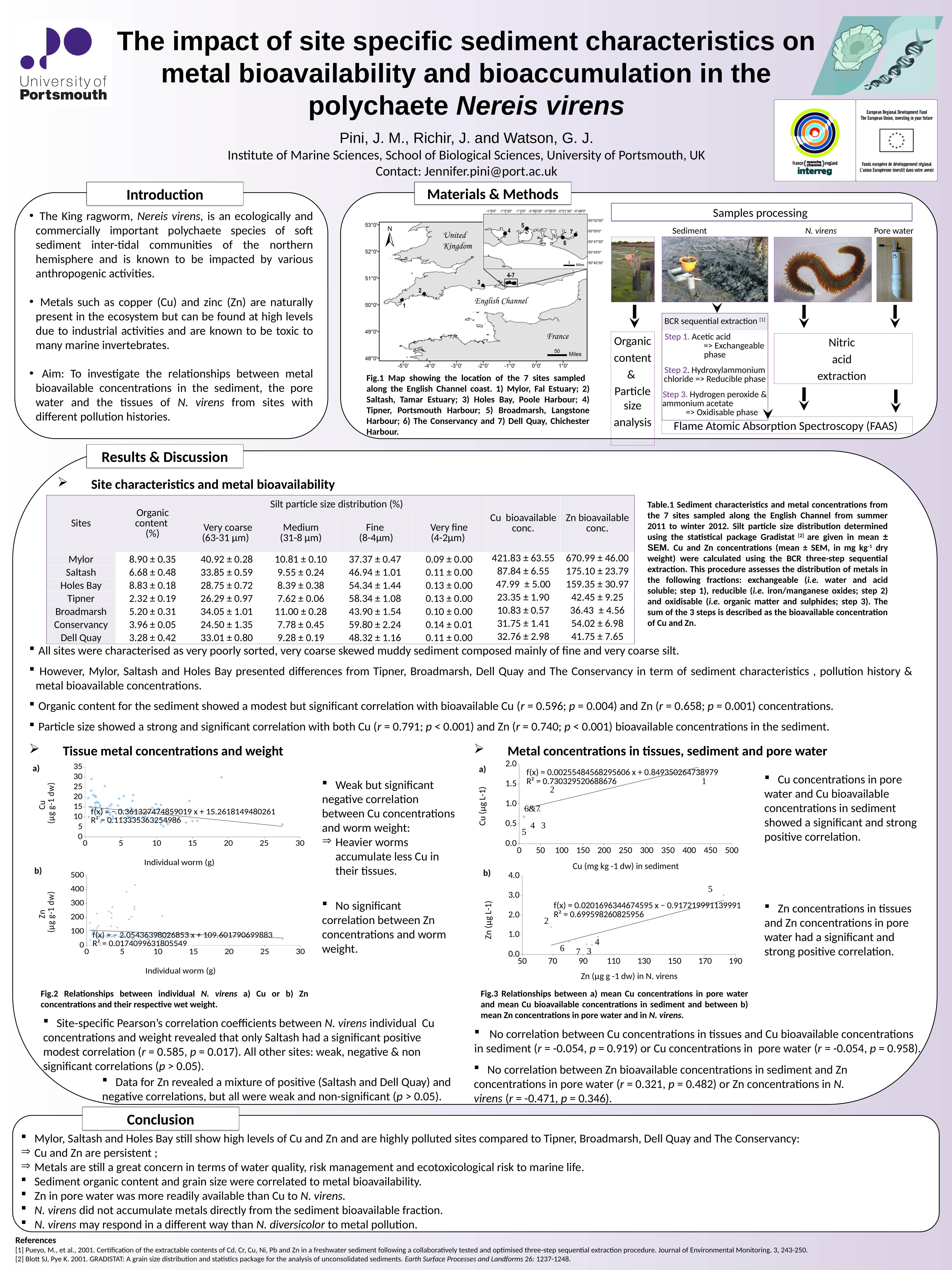
In Fig.3 a), does the fitted trend line rise or fall as Cu in sediment increases? rise In Fig.3 a), what R² value is printed for the fitted line? R² = 0.730329520688676 In Fig.3 b), is the Zn pore water concentration for site 5 greater or less than 2.0? greater In Fig.2 a), does the fitted trend line for Cu concentration rise or fall as individual worm weight increases? fall In Fig.3 a), is the Cu pore water concentration for site 5 greater or less than 0.5? greater In Fig.2 b), what R² value is printed for the fitted line? R² = 0.0174099631805549 In Fig.3 a), which numbered site has the highest Cu concentration in sediment? 1 In Fig.2 a), what R² value is printed for the fitted line? R² = 0.113335363254986 In Fig.3 a), is the Cu concentration in sediment for site 1 greater or less than 400? greater In Fig.3 b), which numbered site has the highest Zn concentration in pore water? 5 In Fig.2 b), what is the label of the y axis? Zn (µg g-1 dw) What kind of chart is Fig.2 a) (Cu concentrations versus individual worm weight)? scatter chart